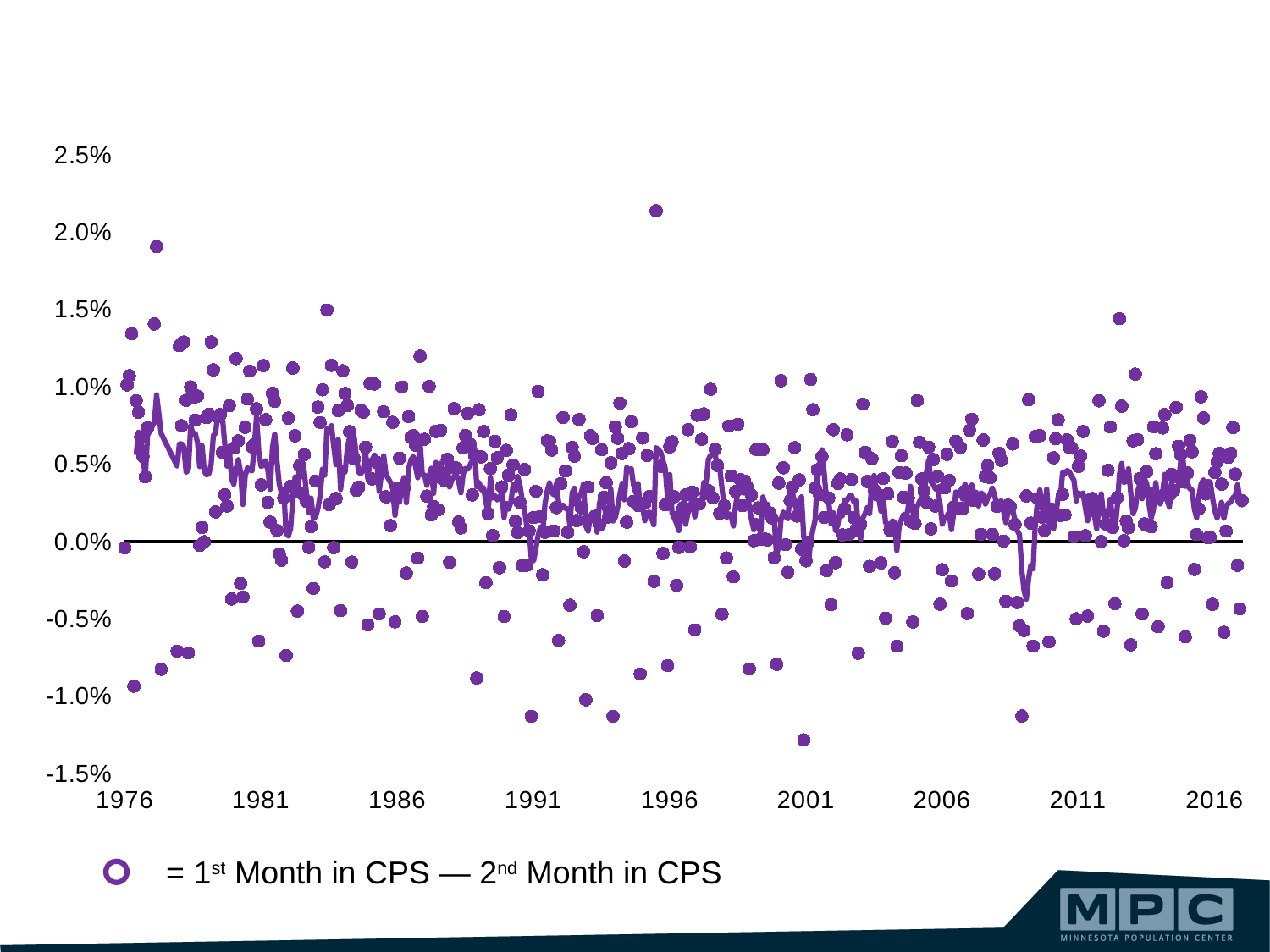
Is the highest plotted point on the chart (near 1996) greater or less than 2.0%? greater How many year labels are shown on the horizontal axis? 9 What is the first year labelled on the horizontal axis? 1976 What is the minimum value shown on the vertical axis? -1.5% Is the lowest point plotted in 1976 greater or less than -0.5%? less What is the maximum value shown on the vertical axis? 2.5% Does the smoothed line on the chart generally rise or fall from 1976 to 2016? fall What kind of chart is shown on the slide? scatter chart Is the lowest plotted point on the chart (near 2001) greater or less than -1.0%? less What is the last year labelled on the horizontal axis? 2016